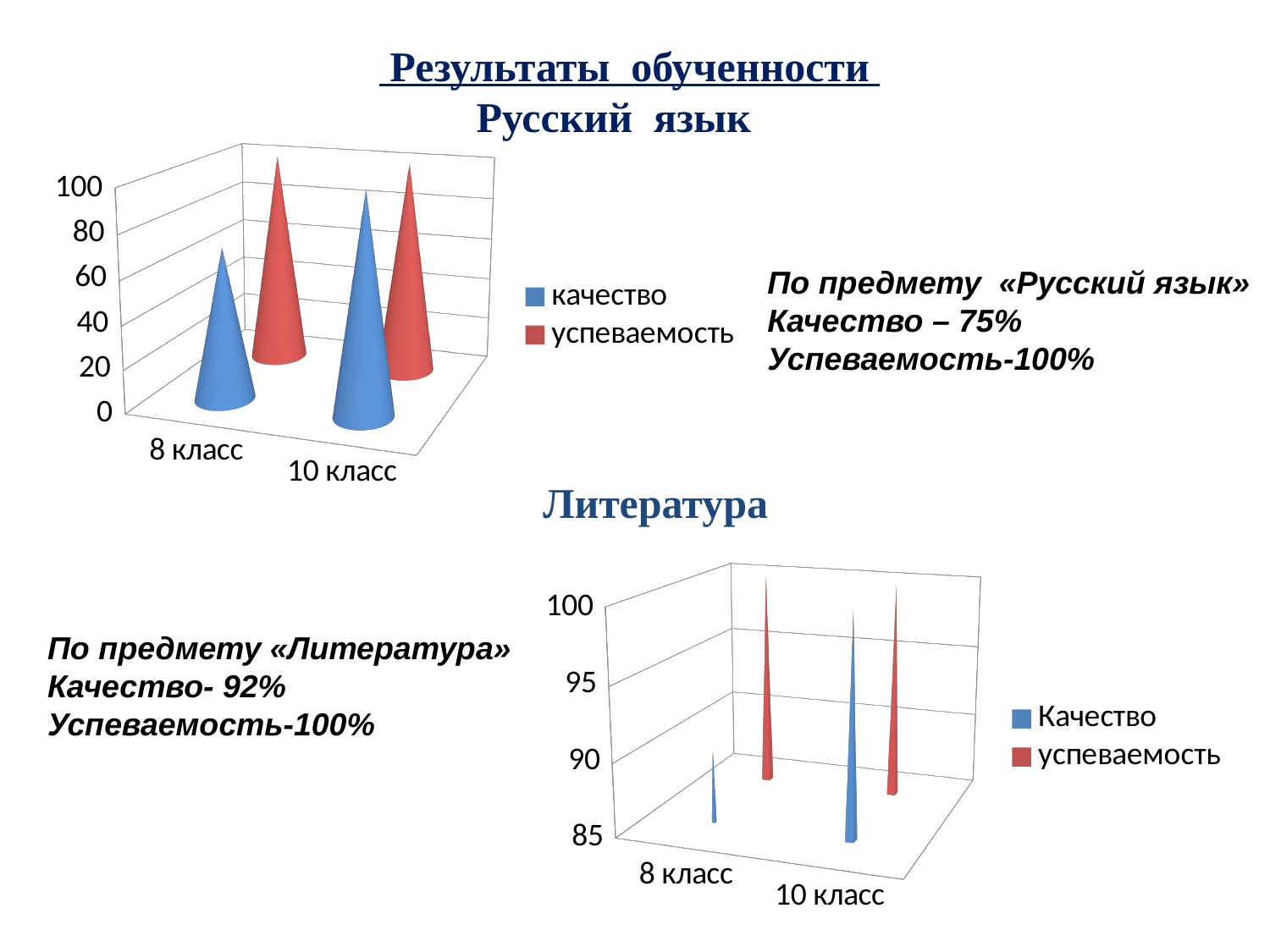
In the Русский язык chart, how many series does the legend list? 2 In the Литература chart, what is the lowest value shown on the vertical axis? 85 In the Русский язык chart, does the качество value rise or fall from 8 класс to 10 класс? rise What kind of chart is the Литература chart? bar chart In the Русский язык chart, which class has the higher качество value, 8 класс or 10 класс? 10 класс In the Литература chart, is the Качество value for 10 класс greater or less than 95? greater In the Русский язык chart, how many class categories are shown on the x axis? 2 In the Русский язык chart, is the качество value for 8 класс greater or less than 40? greater In the Русский язык chart, is the успеваемость value for 8 класс greater or less than 80? greater In the Литература chart, which colour represents успеваемость? red In the Литература chart, which class has the higher Качество value, 8 класс or 10 класс? 10 класс